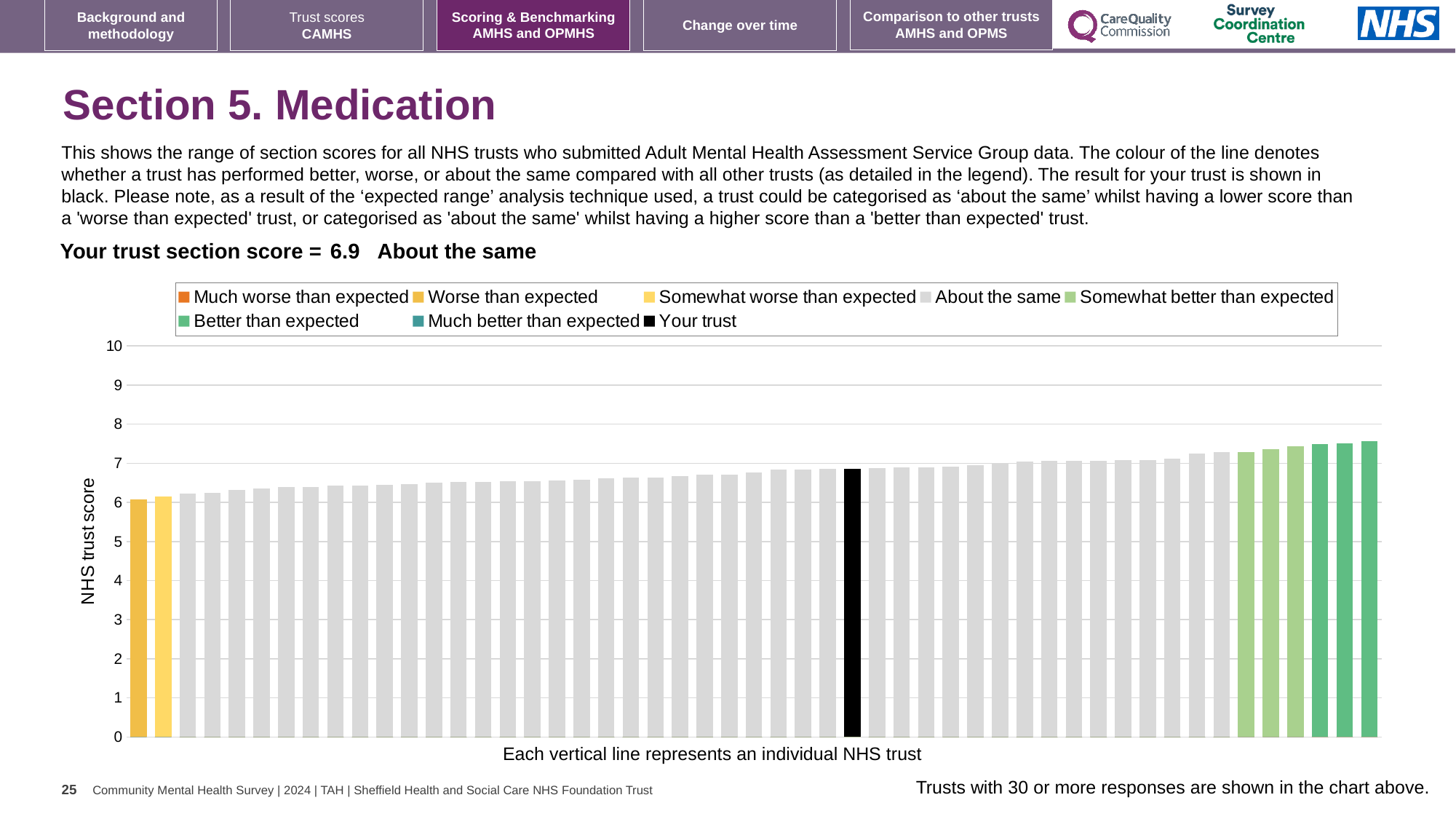
Is the value for your trust (the black bar) greater or less than 5? greater What is the label on the vertical axis of the chart? NHS trust score What is the section score for your trust shown on the slide? 6.9 How many entries does the chart legend list? 8 What kind of chart is shown on the slide? bar chart Is the value of the highest bar in the chart greater or less than 7? greater Do the bar values rise or fall from left to right along the x axis? rise Is the value of the lowest bar in the chart greater or less than 7? less How many bars are coloured yellow (worse than expected) in the chart? 2 Which category is your trust placed in according to the slide? About the same